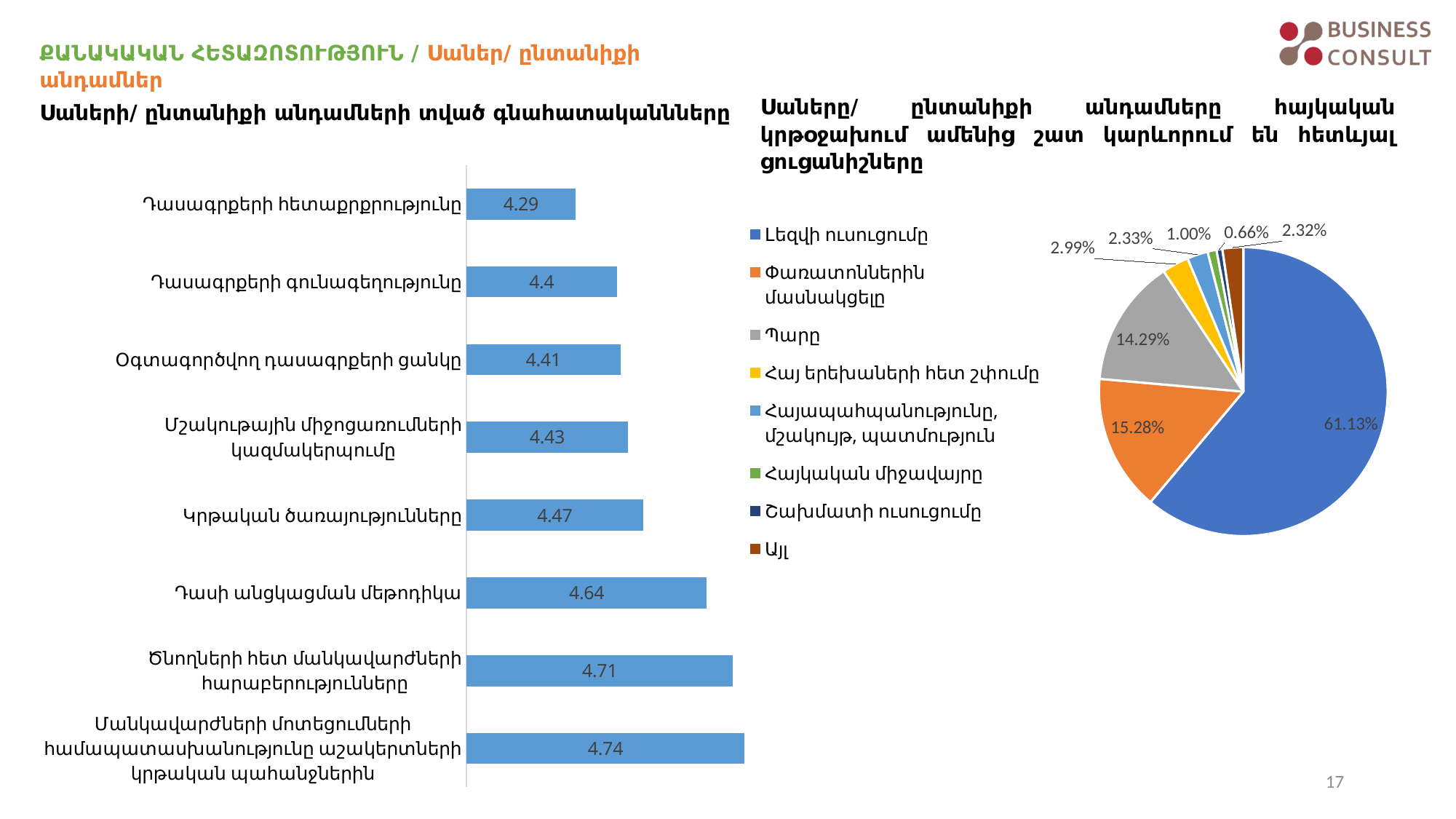
In the bar chart on the left, what is the difference between the values for Ծնողների հետ մանկավարժների հարաբերությունները and Դասագրքերի հետաքրքրությունը? 0.42 In the pie chart on the right, what share does Լեզվի ուսուցումը have? 61.13% In the pie chart on the right, what share does Պարը have? 14.29% How many categories are shown in the bar chart on the left? 8 In the bar chart on the left, which category has the lowest value? Դասագրքերի հետաքրքրությունը In the bar chart on the left, which is larger: the value for Կրթական ծառայությունները or the value for Օգտագործվող դասագրքերի ցանկը? Կրթական ծառայությունները What kind of chart is on the left side of the slide? Bar chart In the pie chart on the right, which category has the smallest share? Շախմատի ուսուցումը In the bar chart on the left, what is the value for Դասագրքերի գունագեղությունը? 4.4 How many entries does the legend of the pie chart on the right list? 8 In the bar chart on the left, which category has the highest value? Մանկավարժների մոտեցումների համապատասխանությունը աշակերտների կրթական պահանջներին In the bar chart on the left, what is the value for Դասի անցկացման մեթոդիկա? 4.64